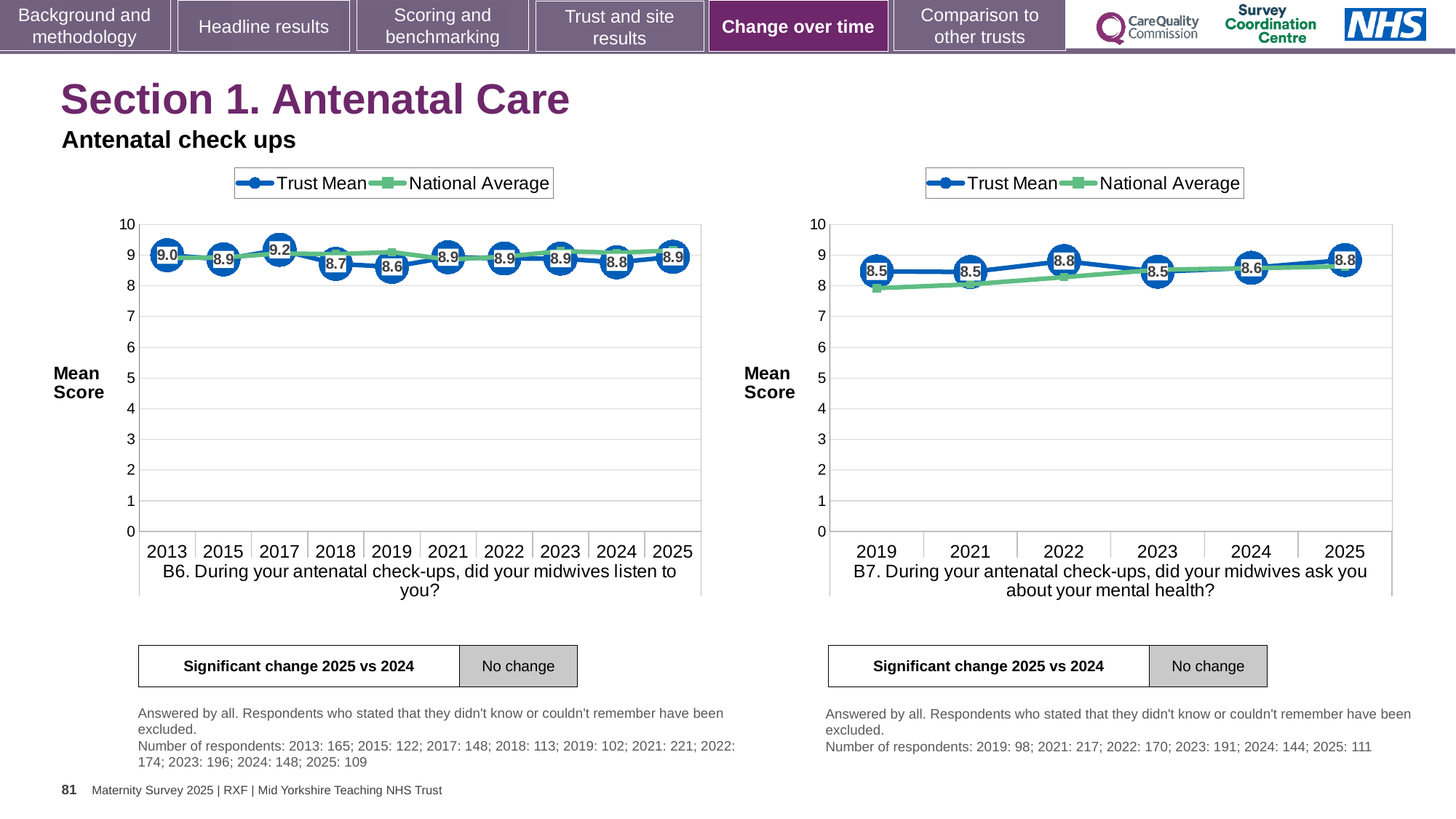
What type of chart is used for the B7 question on the right? Line chart In the left chart (B6), which year has the highest Trust Mean score? 2017 In the left chart (B6), what is the Trust Mean score for 2025? 8.9 In the right chart (B7), what is the Trust Mean score for 2024? 8.6 In the left chart (B6), what is the Trust Mean score for 2017? 9.2 In the right chart (B7), what is the Trust Mean score for 2022? 8.8 In the right chart (B7), what is the difference between the Trust Mean scores for 2022 and 2023? 0.3 In the left chart (B6), which year has the lowest Trust Mean score? 2019 In the left chart (B6), what is the difference between the Trust Mean scores for 2017 and 2019? 0.6 How many years are plotted on the left chart (B6)? 10 In the right chart (B7), is the Trust Mean score higher in 2025 or in 2019? 2025 How many series does the legend of the right chart (B7) list? 2